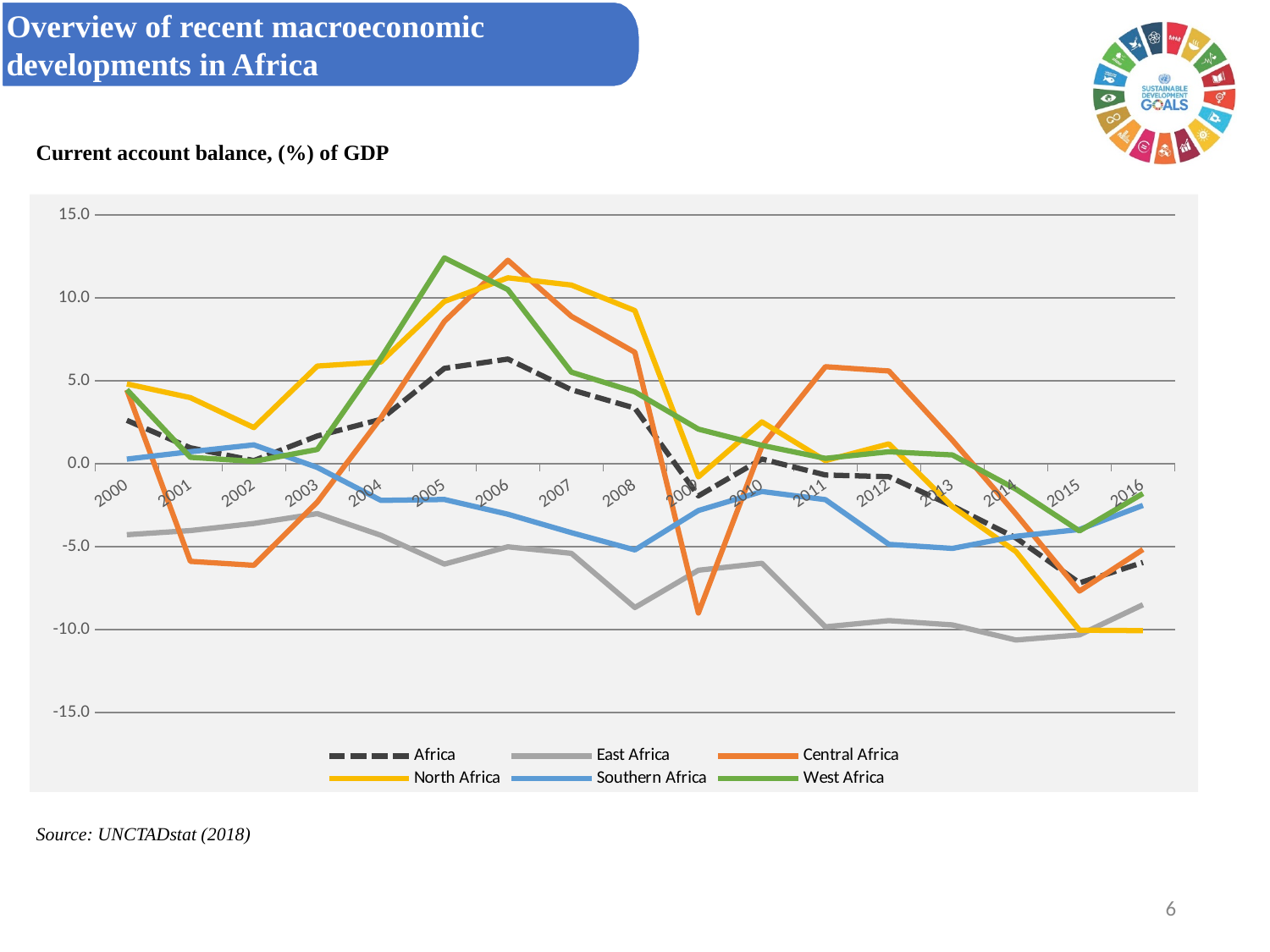
Does the North Africa line rise or fall from 2012 to 2015? fall Which series has the highest value in 2005? West Africa Is the value for East Africa in 2009 greater or less than -5.0? less Is the value for West Africa in 2005 greater or less than 10.0? greater How many series does the legend list? 6 How many years are plotted along the x axis? 17 What is the title of the chart? Current account balance, (%) of GDP Is the value for Africa in 2006 greater or less than 5.0? greater Which series has the lowest value in 2009? Central Africa In 2016, which is higher: Southern Africa or North Africa? Southern Africa What kind of chart is shown on the slide? line chart